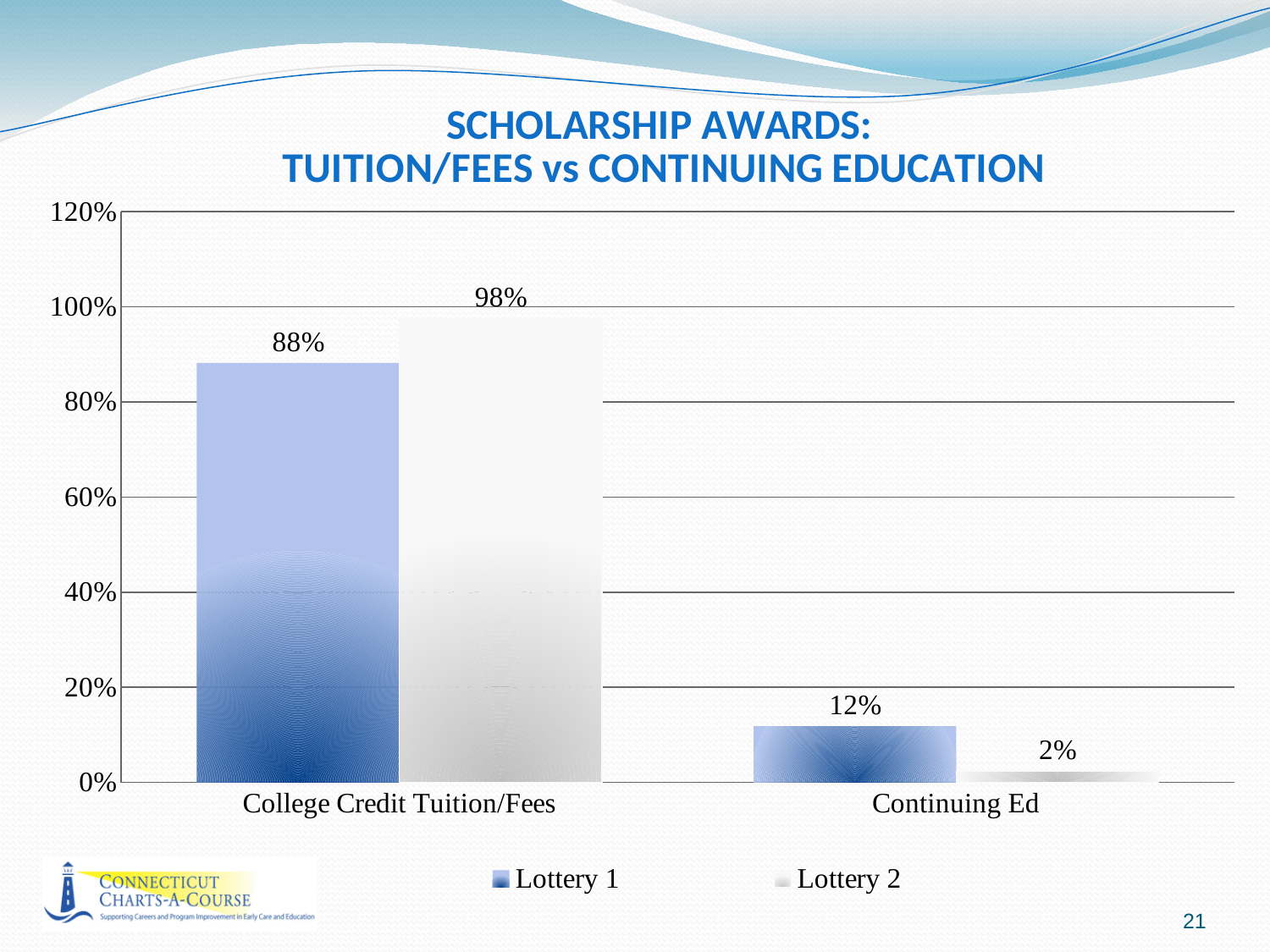
What is the difference between the Lottery 2 and Lottery 1 values for College Credit Tuition/Fees? 10% What is the Lottery 1 value for Continuing Ed? 12% What is the difference between the Lottery 1 and Lottery 2 values for Continuing Ed? 10% How many series does the legend list? 2 What is the Lottery 2 value for Continuing Ed? 2% What is the Lottery 1 value for College Credit Tuition/Fees? 88% What kind of chart is shown on the slide? Bar chart What is the Lottery 2 value for College Credit Tuition/Fees? 98% How many categories are shown on the x axis? 2 Which category has the highest Lottery 2 value? College Credit Tuition/Fees For Continuing Ed, which series has the larger value, Lottery 1 or Lottery 2? Lottery 1 Which category has the lowest Lottery 1 value? Continuing Ed